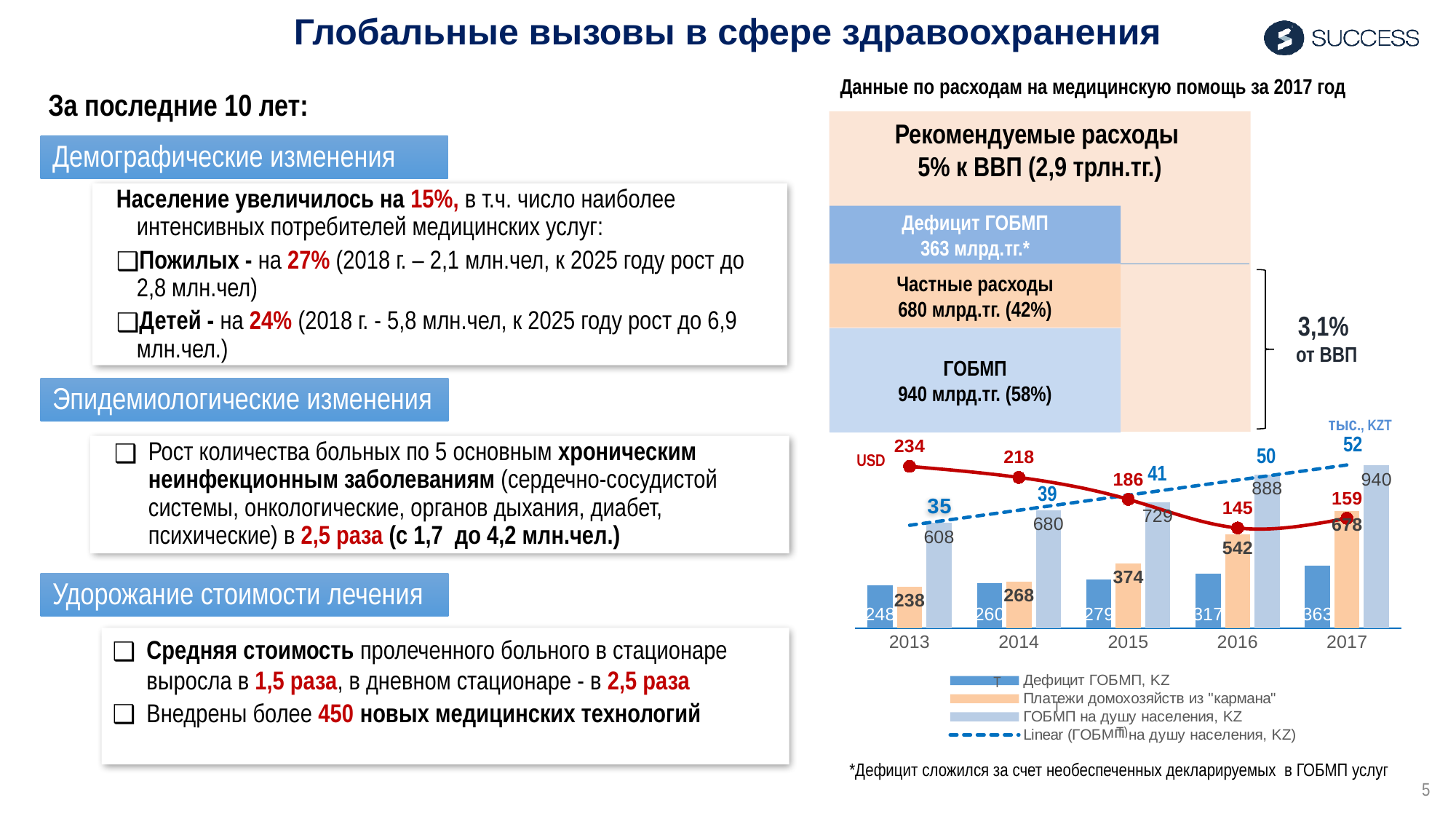
In the bar chart at the bottom right, what is the USD value shown on the red line for 2014? 218 In the bar chart at the bottom right, which is larger for 2014: Дефицит ГОБМП, KZ or Платежи домохозяйств из "кармана"? Платежи домохозяйств из "кармана" In the bar chart at the bottom right, which year has the highest value of ГОБМП на душу населения, KZ? 2017 In the bar chart at the bottom right, what is the value of Дефицит ГОБМП, KZ for 2017? 363 In the bar chart at the bottom right, what is the value of Платежи домохозяйств из "кармана" for 2015? 374 In the bar chart at the bottom right, do the values of Дефицит ГОБМП, KZ rise or fall from 2013 to 2017? rise In the bar chart at the bottom right, which year has the lowest USD value on the red line? 2016 In the bar chart at the bottom right, what colour are the bars for Платежи домохозяйств из "кармана"? orange In the bar chart at the bottom right, how many years are shown on the x axis? 5 In the bar chart at the bottom right, what is the difference between the Платежи домохозяйств из "кармана" values for 2017 and 2016? 136 In the bar chart at the bottom right, how many entries does the legend list? 4 In the bar chart at the bottom right, what is the value of ГОБМП на душу населения, KZ for 2013? 608